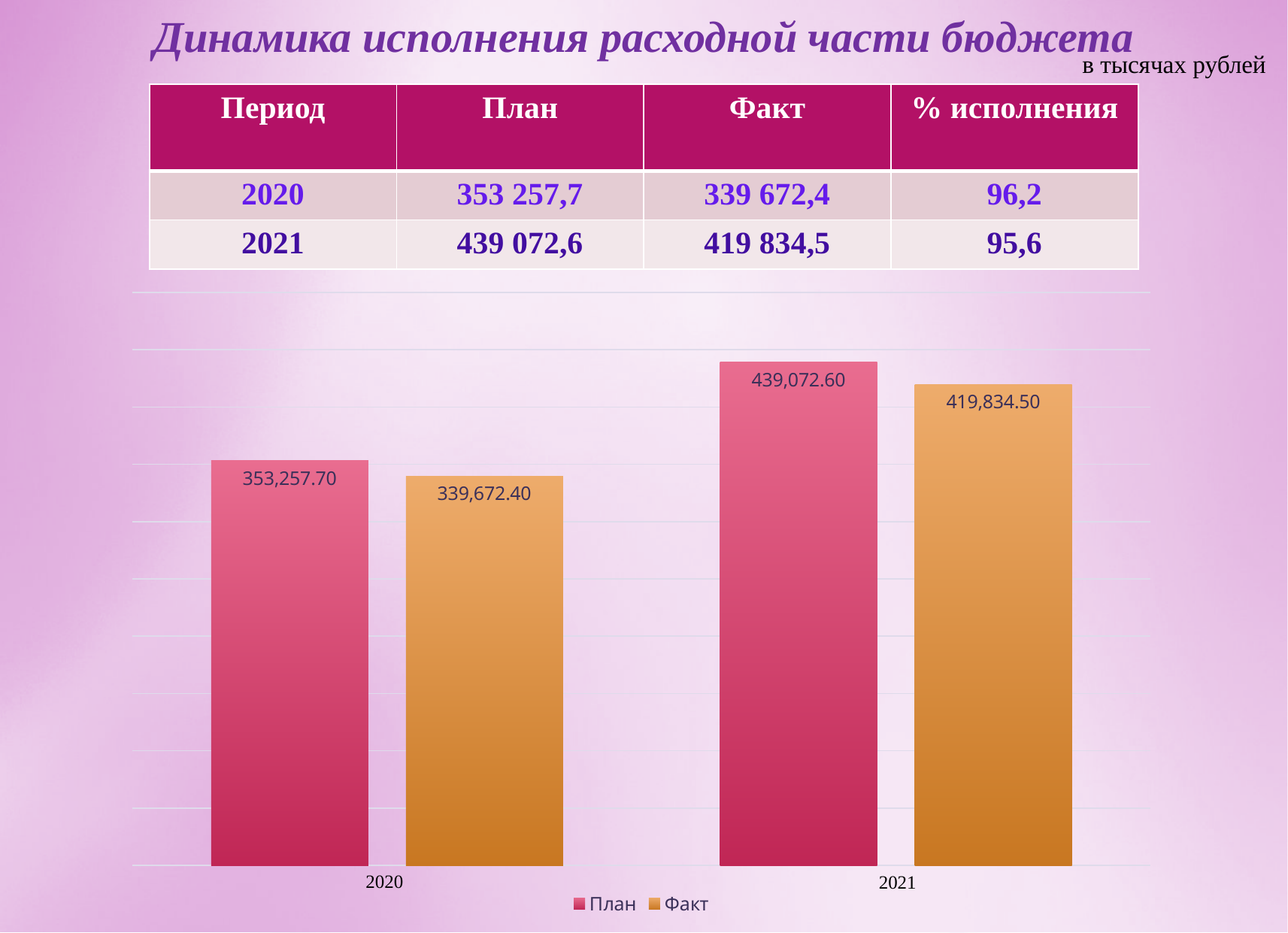
What is the difference between the План and Факт values for 2021 in the chart? 19,238.10 In the chart, which is larger: the Факт value for 2021 or the План value for 2020? Факт value for 2021 What is the value of the План bar for 2020 in the chart? 353,257.70 What is the value of the Факт bar for 2021 in the chart? 419,834.50 How many categories are shown on the x axis of the chart? 2 What type of chart is shown on the slide? Bar chart What is the value of the Факт bar for 2020 in the chart? 339,672.40 What is the difference between the План and Факт values for 2020 in the chart? 13,585.30 How many series does the chart legend list? 2 What is the value of the План bar for 2021 in the chart? 439,072.60 Which bar in the chart has the lowest value? Факт for 2020 Which bar in the chart has the highest value? План for 2021